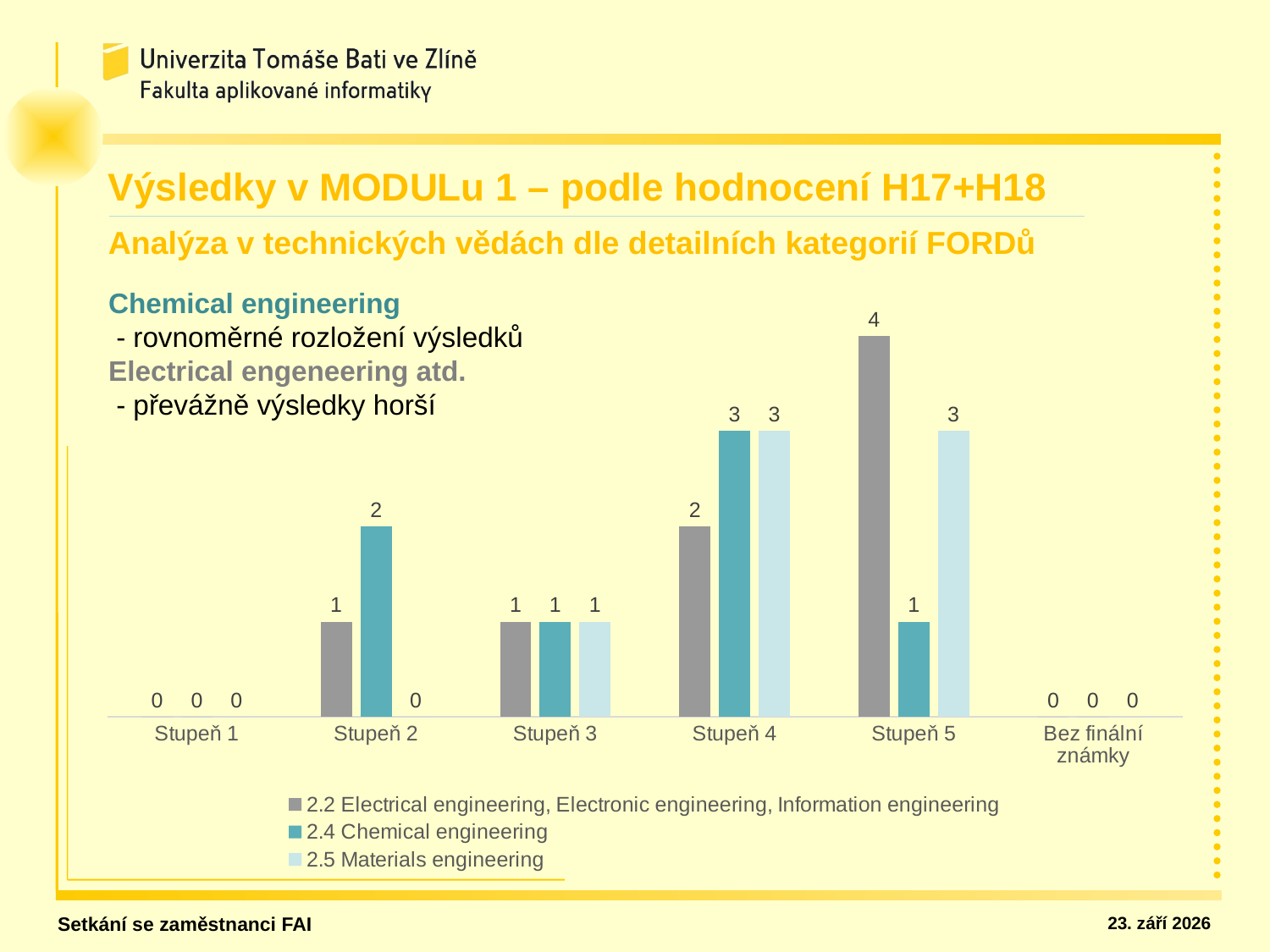
What is the value for 2.4 Chemical engineering at Stupeň 2? 2 How many series does the legend list? 3 At which category does the 2.2 Electrical engineering, Electronic engineering, Information engineering series reach its highest value? Stupeň 5 Which is larger at Stupeň 2: the value for 2.4 Chemical engineering or the value for 2.5 Materials engineering? 2.4 Chemical engineering What is the value for 2.2 Electrical engineering, Electronic engineering, Information engineering at Stupeň 5? 4 What is the difference between the 2.2 Electrical engineering series and the 2.4 Chemical engineering series at Stupeň 5? 3 What is the value for 2.5 Materials engineering at Stupeň 4? 3 What is the value for 2.5 Materials engineering at Bez finální známky? 0 Which series is shown in the darkest grey colour in the legend? 2.2 Electrical engineering, Electronic engineering, Information engineering At which category does the 2.4 Chemical engineering series reach its highest value? Stupeň 4 What type of chart is shown on the slide? bar chart How many categories are shown on the x axis? 6